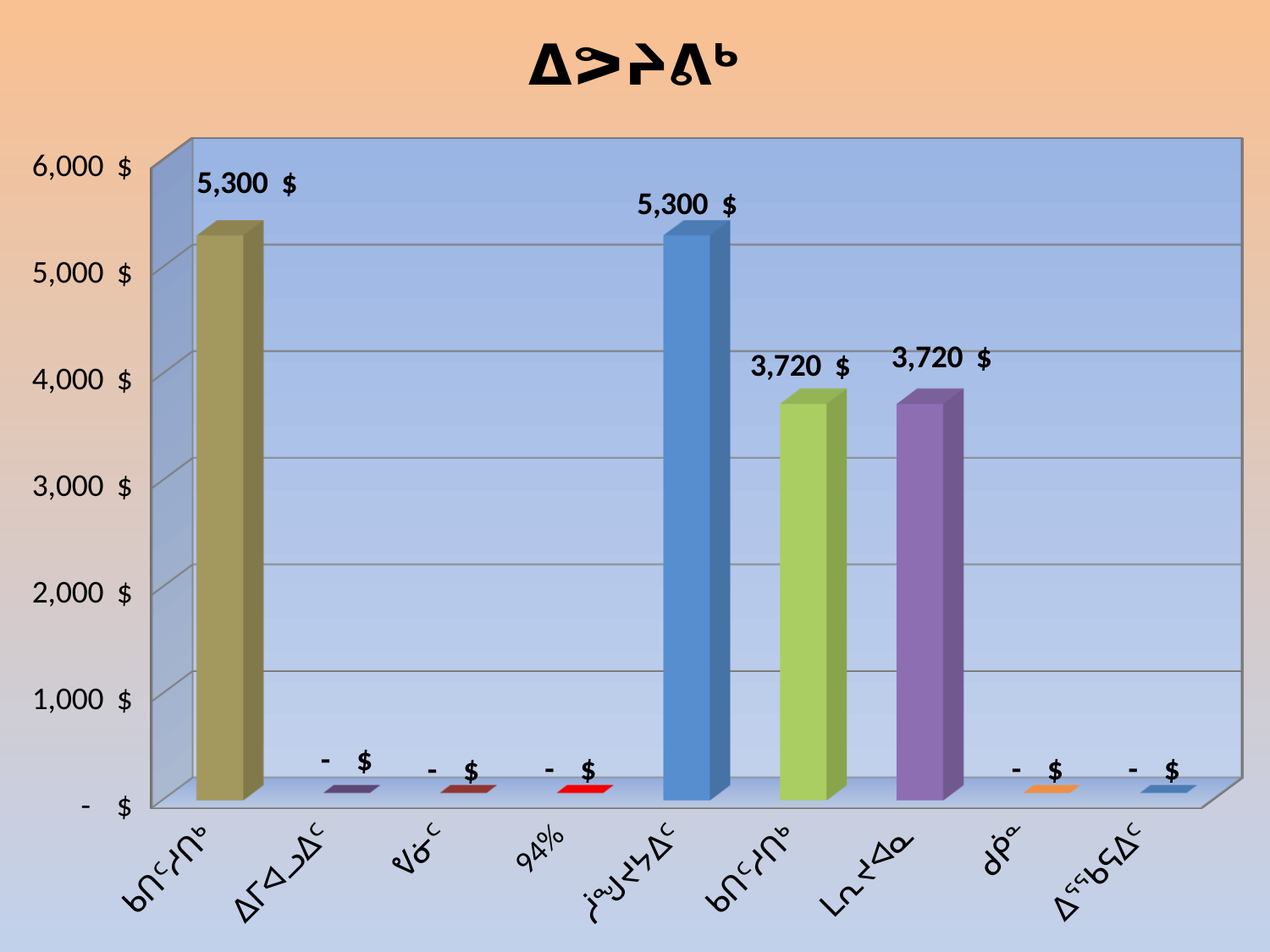
What is the value of the first (leftmost) bar in the chart? 5,300 $ What is the value of the tall blue bar (fifth category) in the chart? 5,300 $ What kind of chart is shown on the slide? bar chart Is the value of the green sixth bar greater or less than 4,000 $? less What is the difference between the value of the first bar (5,300 $) and the green sixth bar (3,720 $)? 1,580 $ How many categories are shown along the x axis of the chart? 9 How many categories in the chart have a value of "- $"? 5 What is the value of the category labelled "94%"? - $ Which is larger, the value of the fifth bar or the value of the seventh bar? the fifth bar (5,300 $) What is the highest value shown on the vertical axis of the chart? 6,000 $ What is the value of the purple bar (seventh category) in the chart? 3,720 $ What is the value of the green bar (sixth category) in the chart? 3,720 $